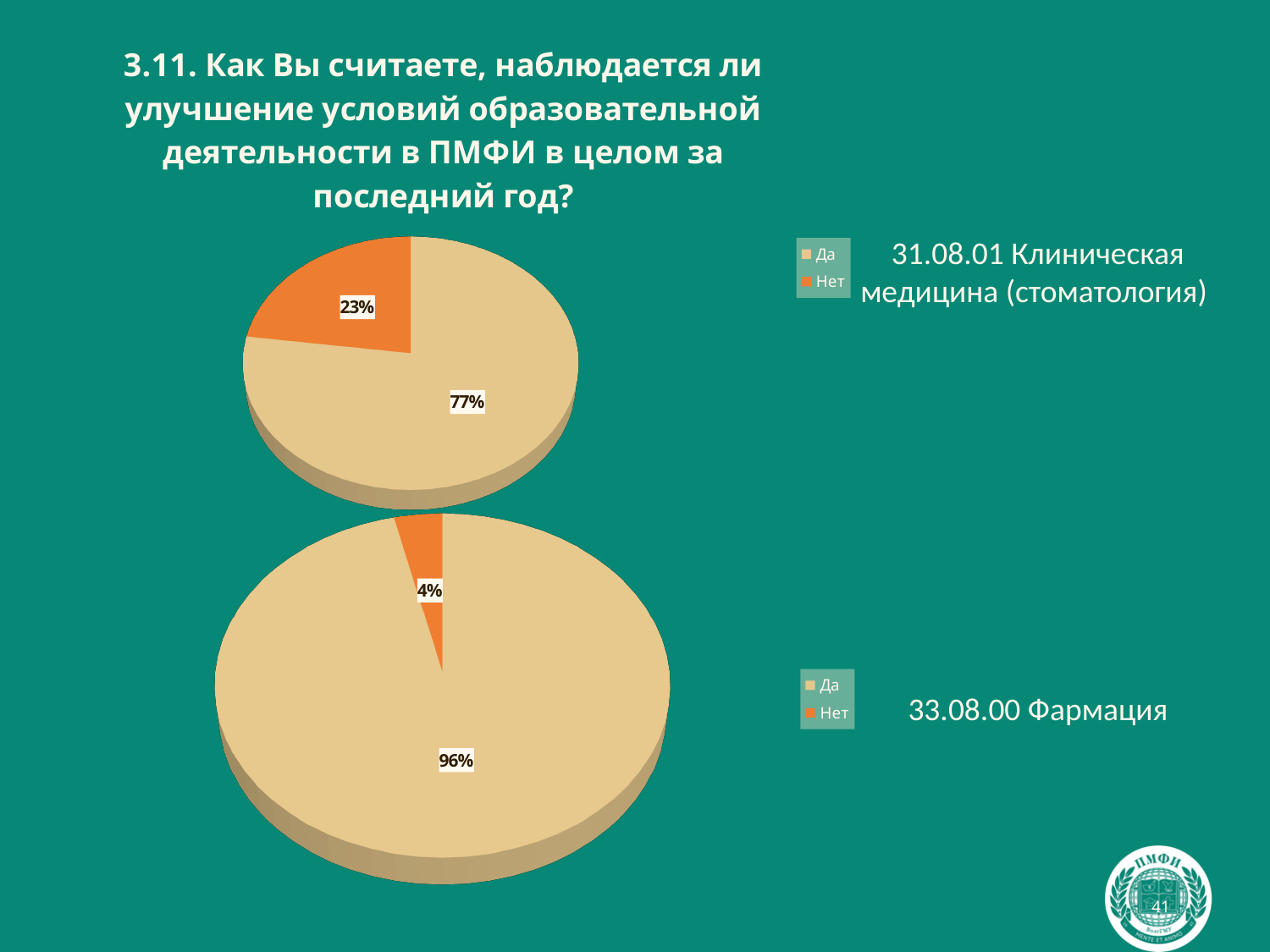
How many slices does the bottom pie chart (33.08.00 Фармация) have? 2 In the top pie chart (31.08.01 Клиническая медицина (стоматология)), what share of respondents answered "Да"? 77% In the bottom pie chart (33.08.00 Фармация), what share of respondents answered "Да"? 96% In the top pie chart (31.08.01 Клиническая медицина (стоматология)), what is the difference in percentage points between the "Да" and "Нет" slices? 54 percentage points In the top pie chart (31.08.01 Клиническая медицина (стоматология)), which answer has the largest slice? Да Which chart has the larger "Нет" share: the top chart (31.08.01 Клиническая медицина (стоматология)) or the bottom chart (33.08.00 Фармация)? The top chart (31.08.01 Клиническая медицина (стоматология)) In the bottom pie chart (33.08.00 Фармация), what share of respondents answered "Нет"? 4% How many entries does the legend of the top pie chart list? 2 What type of chart is used on this slide? Pie chart In the top pie chart (31.08.01 Клиническая медицина (стоматология)), what share of respondents answered "Нет"? 23% In the bottom pie chart (33.08.00 Фармация), what colour is the "Нет" slice? Orange In the bottom pie chart (33.08.00 Фармация), which answer has the smallest slice? Нет